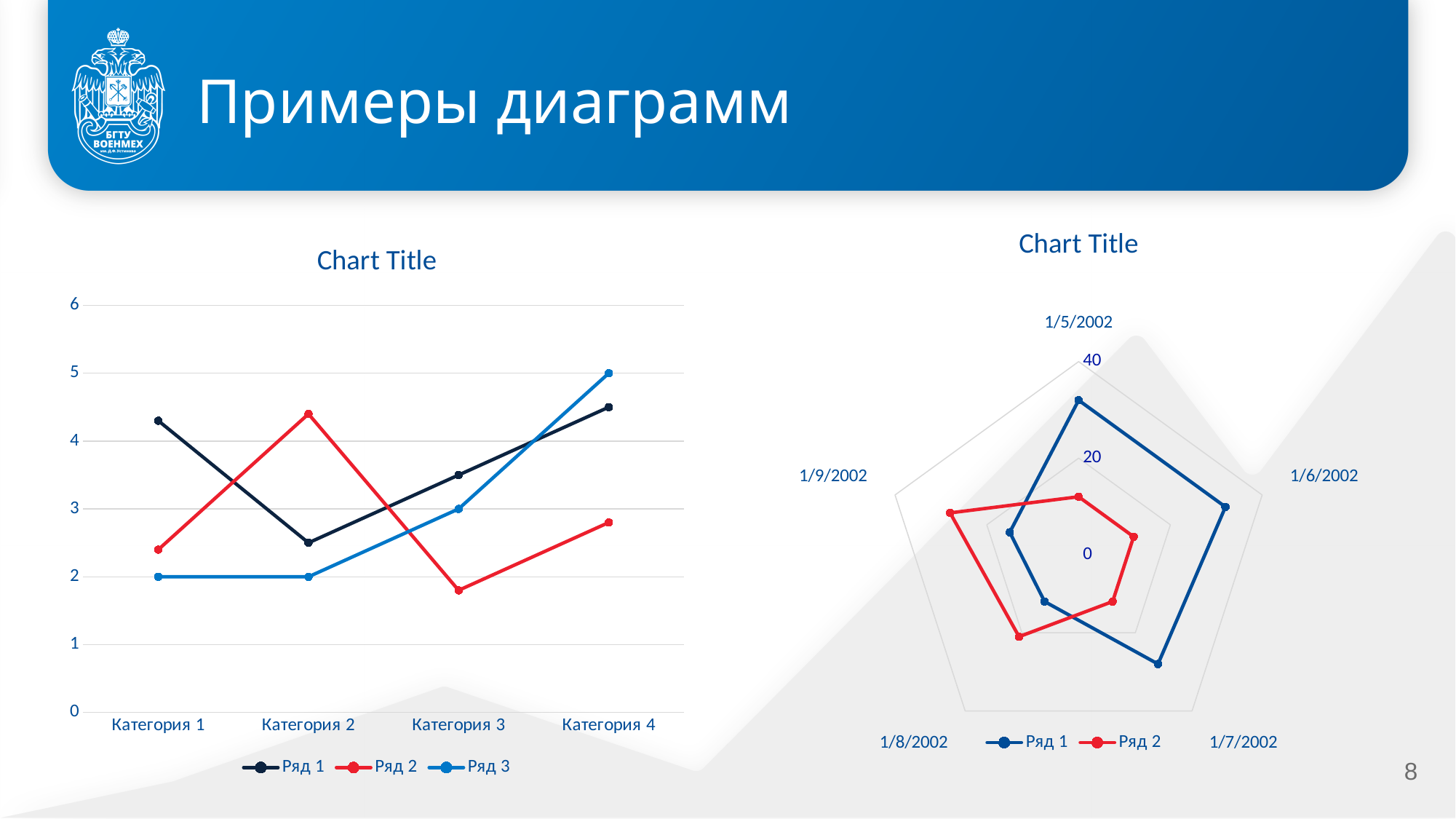
In the left chart, at which category does Ряд 2 reach its lowest value? Категория 3 In the left chart, what is the value of Ряд 3 at Категория 1? 2 In the left chart, what is the difference between the Ряд 3 values at Категория 4 and Категория 1? 3 In the right chart, is the value of Ряд 1 at 1/5/2002 greater or less than 20? greater In the right chart, how many series does the legend list? 2 In the left chart, what is the value of Ряд 3 at Категория 4? 5 What type of chart is the chart on the right side of the slide? radar chart In the left chart, at Категория 2, which series has the larger value, Ряд 1 or Ряд 2? Ряд 2 What type of chart is the chart on the left side of the slide? line chart In the right chart, how many axes (date categories) are there? 5 In the left chart, how many series does the legend list? 3 In the left chart, how many categories are shown on the x axis? 4